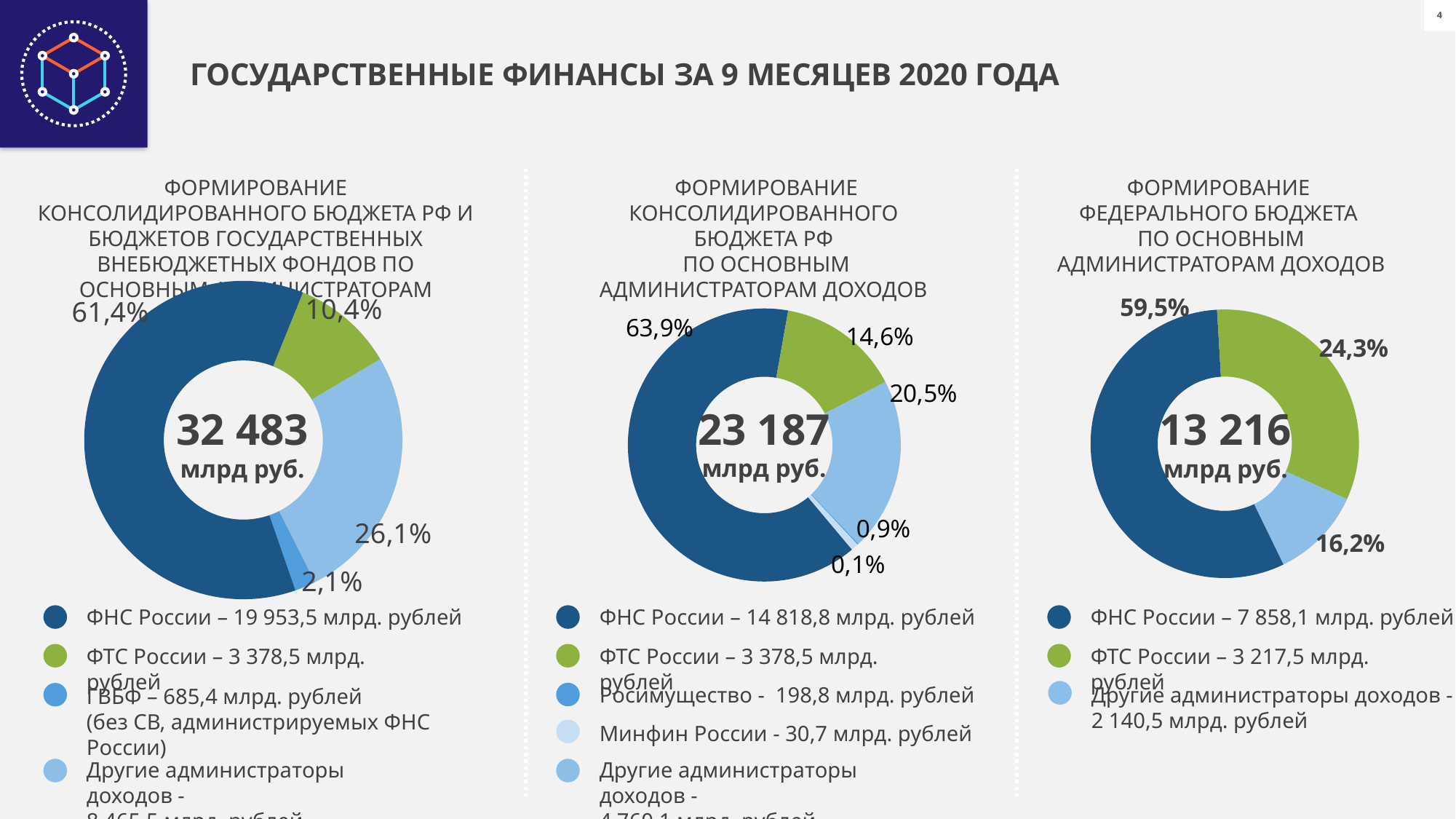
What kind of chart is used on this slide to show the budget formation by revenue administrators? Pie (donut) chart In the middle chart, what is the value for Росимущество according to the legend? 198,8 млрд. рублей In the right chart, what is the difference in percentage points between the ФНС России share and the ФТС России share? 35,2 In the right chart, which is larger: the share of ФТС России or the share of Другие администраторы доходов? ФТС России In the middle chart (consolidated budget of the RF by main revenue administrators), what share does ФТС России have? 14,6% In the right chart, what is the value for ФНС России according to the legend? 7 858,1 млрд. рублей In the middle chart, which administrator has the smallest share? Минфин России In the middle chart, how many slices (categories) does the donut have? 5 In the right chart (federal budget by main revenue administrators), what is the total shown in the centre? 13 216 млрд руб. In the left chart (consolidated budget of the RF and state extra-budgetary funds), what share does ФНС России account for? 61,4% In the left chart, what share is attributed to ГВБФ? 2,1% In the left chart, what is the total value shown in the centre of the donut? 32 483 млрд руб.